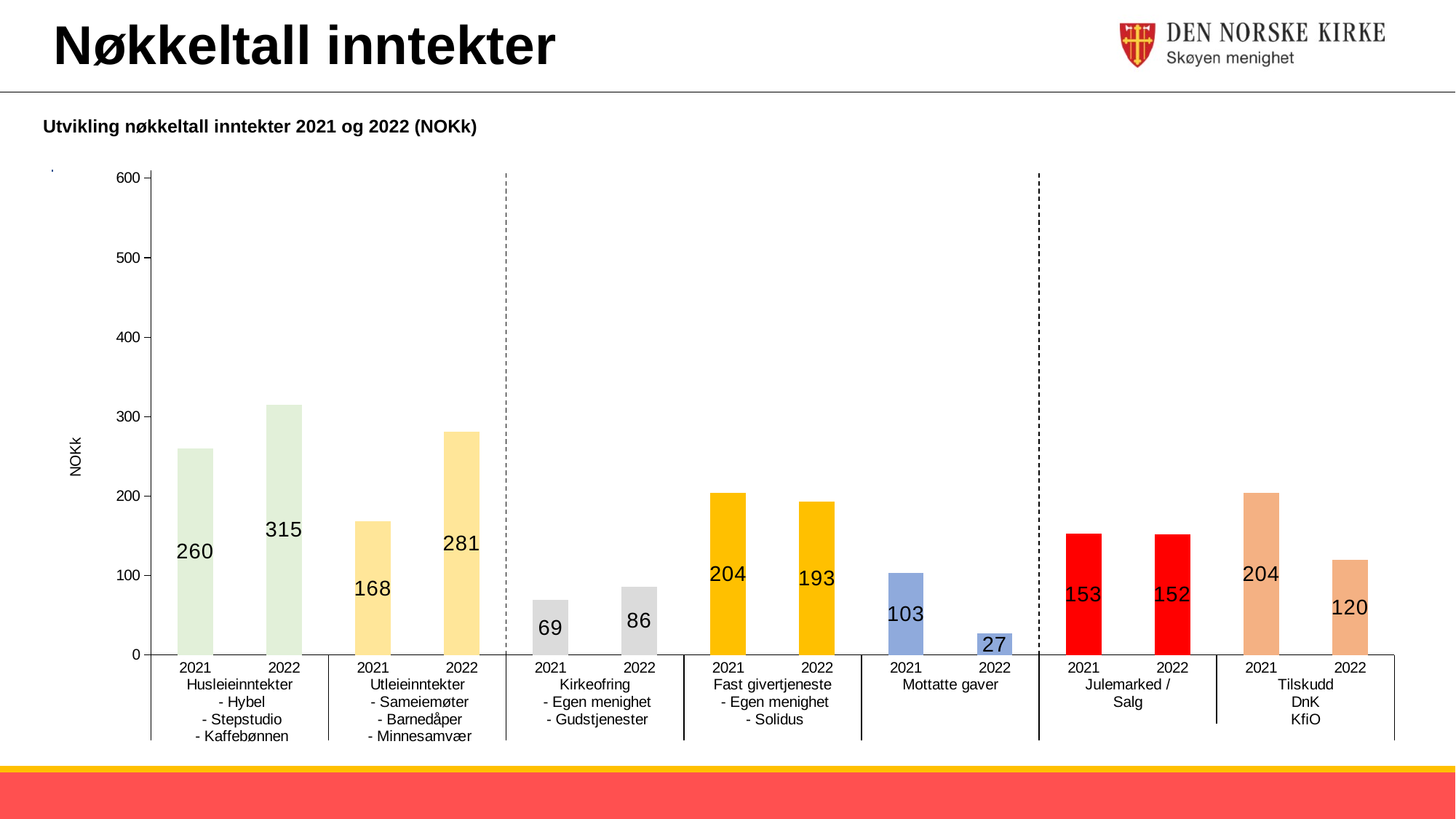
What is the difference between the 2022 and 2021 values for Utleieinntekter? 113 Is the value for Husleieinntekter in 2021 greater or less than 200? greater What is the title of the chart? Utvikling nøkkeltall inntekter 2021 og 2022 (NOKk) What is the value for Mottatte gaver in 2021? 103 Which bar has the highest value on the chart? Husleieinntekter 2022 What is the value for Kirkeofring in 2022? 86 How many categories are shown on the x axis of the chart? 7 What is the value for Husleieinntekter in 2022? 315 Which bar has the lowest value on the chart? Mottatte gaver 2022 What is the difference between the 2021 and 2022 values for Tilskudd? 84 What kind of chart is shown on the slide? Bar chart Which is larger, Fast givertjeneste in 2021 or Fast givertjeneste in 2022? Fast givertjeneste in 2021